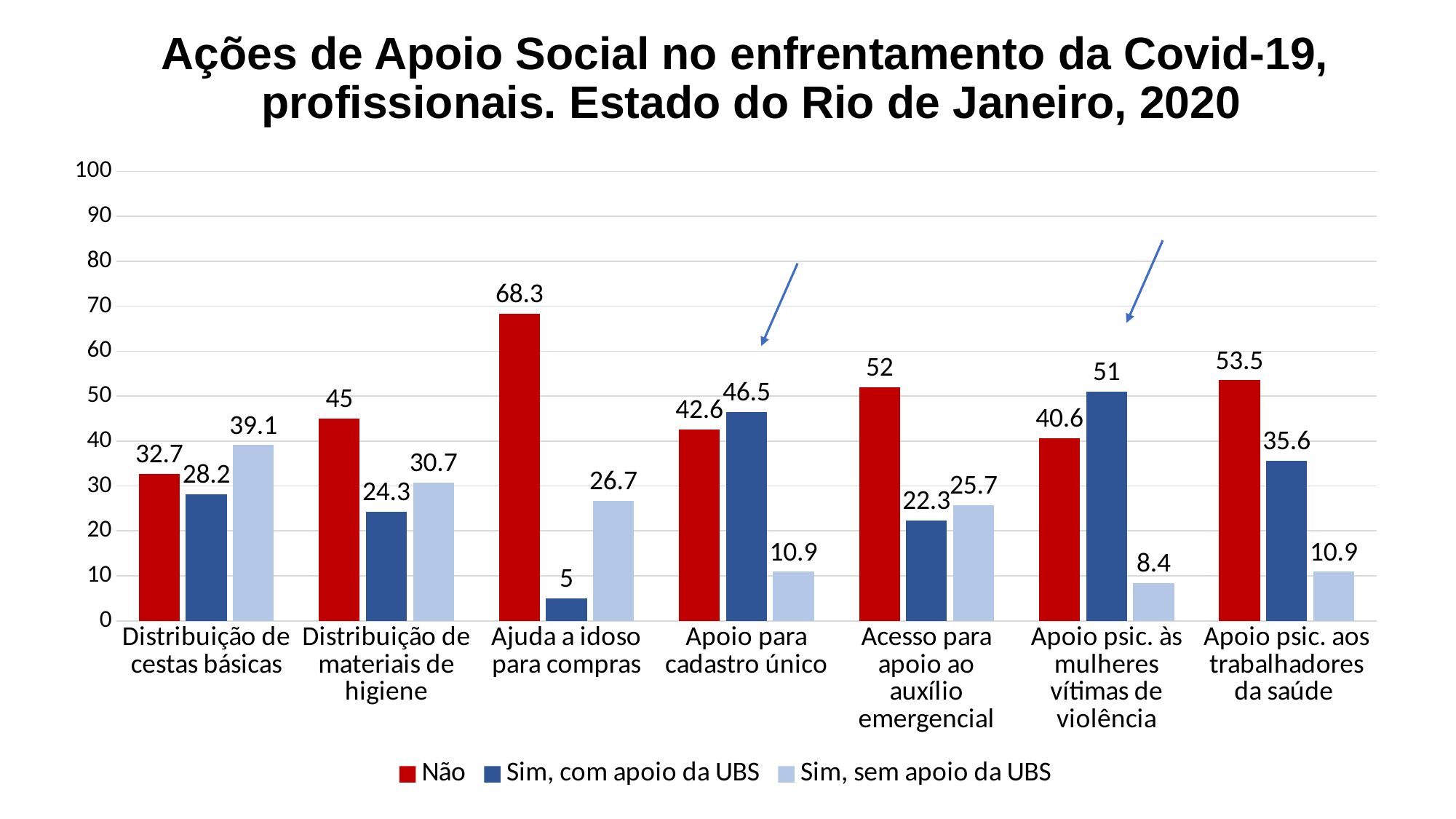
What kind of chart is shown on the slide? Bar chart Which series is shown in red in the legend? Não What is the value of "Sim, sem apoio da UBS" for "Apoio psic. às mulheres vítimas de violência"? 8.4 What is the value of "Sim, sem apoio da UBS" for "Distribuição de cestas básicas"? 39.1 What is the value of "Sim, com apoio da UBS" for "Apoio psic. às mulheres vítimas de violência"? 51 What is the difference between the "Não" and "Sim, com apoio da UBS" values for "Apoio psic. aos trabalhadores da saúde"? 17.9 How many categories are shown on the x axis? 7 Which category has the lowest "Sim, com apoio da UBS" value? Ajuda a idoso para compras How many series does the legend list? 3 Which is larger for "Apoio para cadastro único": "Não" or "Sim, com apoio da UBS"? Sim, com apoio da UBS Which category has the highest "Não" value? Ajuda a idoso para compras What is the value of "Não" for "Ajuda a idoso para compras"? 68.3